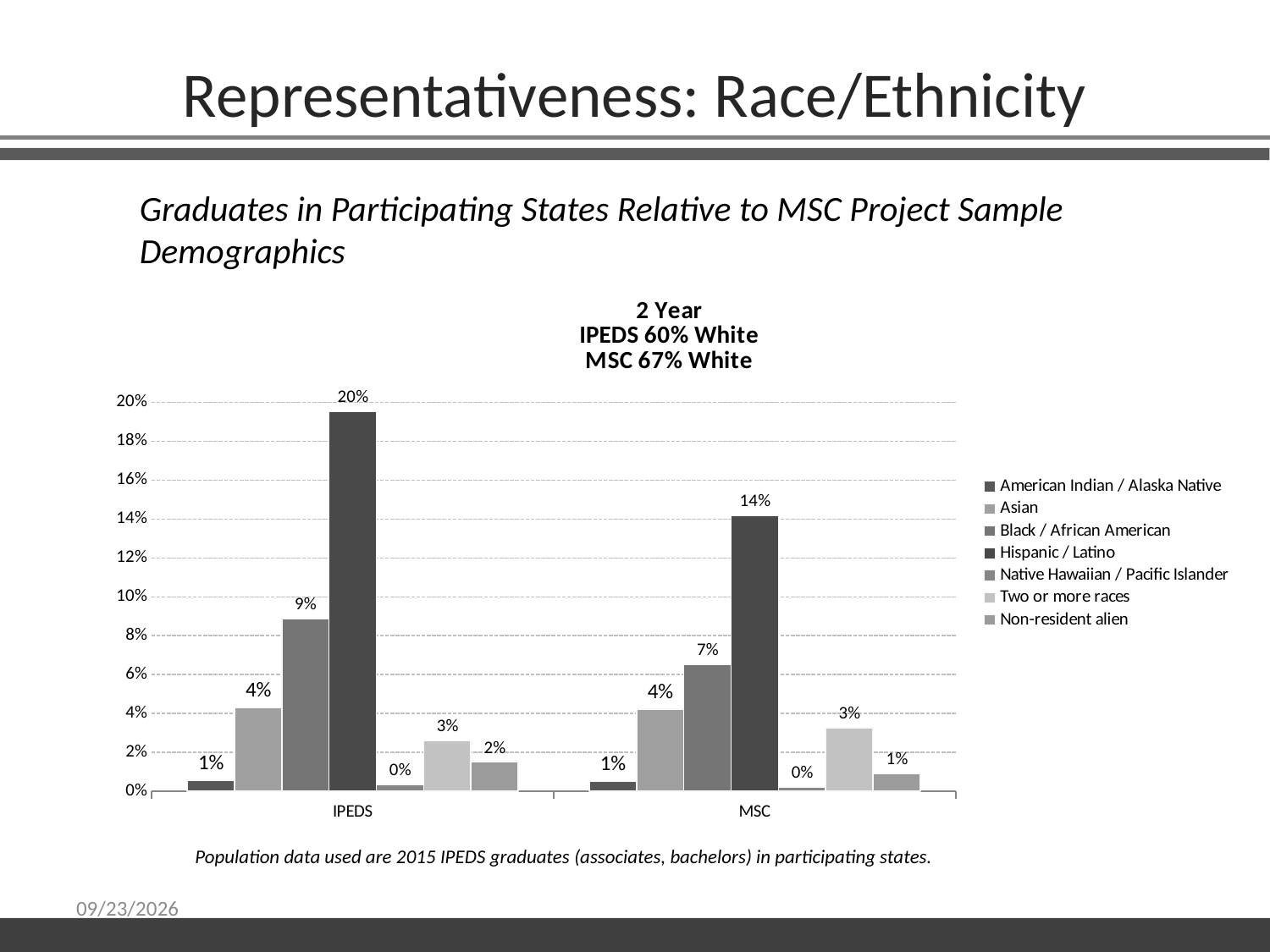
Which group has the larger Black / African American value, IPEDS or MSC? IPEDS What kind of chart is shown on the slide? Bar chart What is the value for Non-resident alien in the MSC group? 1% What is the value for Hispanic / Latino in the IPEDS group? 20% How many groups are shown on the x axis? 2 What is the difference between the Hispanic / Latino values for IPEDS and MSC? 6% What is the title of the chart? 2 Year IPEDS 60% White MSC 67% White Which series has the highest value in the IPEDS group? Hispanic / Latino What is the value for Hispanic / Latino in the MSC group? 14% Is the value for Hispanic / Latino in the MSC group greater or less than 10%? greater How many series does the legend list? 7 What is the value for Black / African American in the IPEDS group? 9%